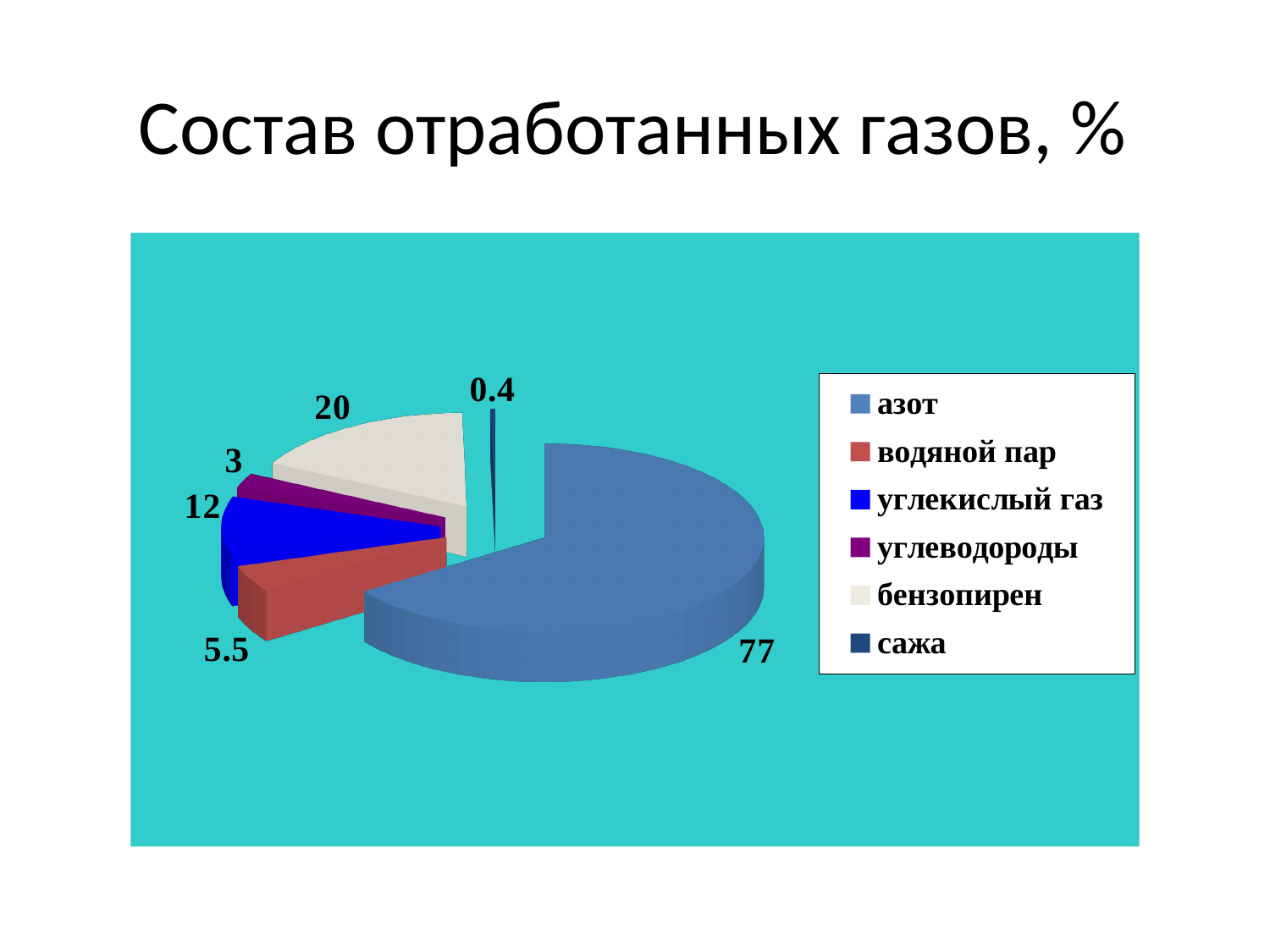
Which is larger, the value for углекислый газ or the value for водяной пар? углекислый газ What is the value shown for сажа? 0.4 Which category has the smallest slice of the pie? сажа Which category has the largest slice of the pie? азот How many categories does the legend list? 6 What is the value shown for бензопирен? 20 What kind of chart is shown on the slide? pie chart What is the value shown for углекислый газ? 12 What is the value shown for азот? 77 What is the difference between the values for азот and бензопирен? 57 What is the title of the chart? Состав отработанных газов, % What is the value shown for водяной пар? 5.5